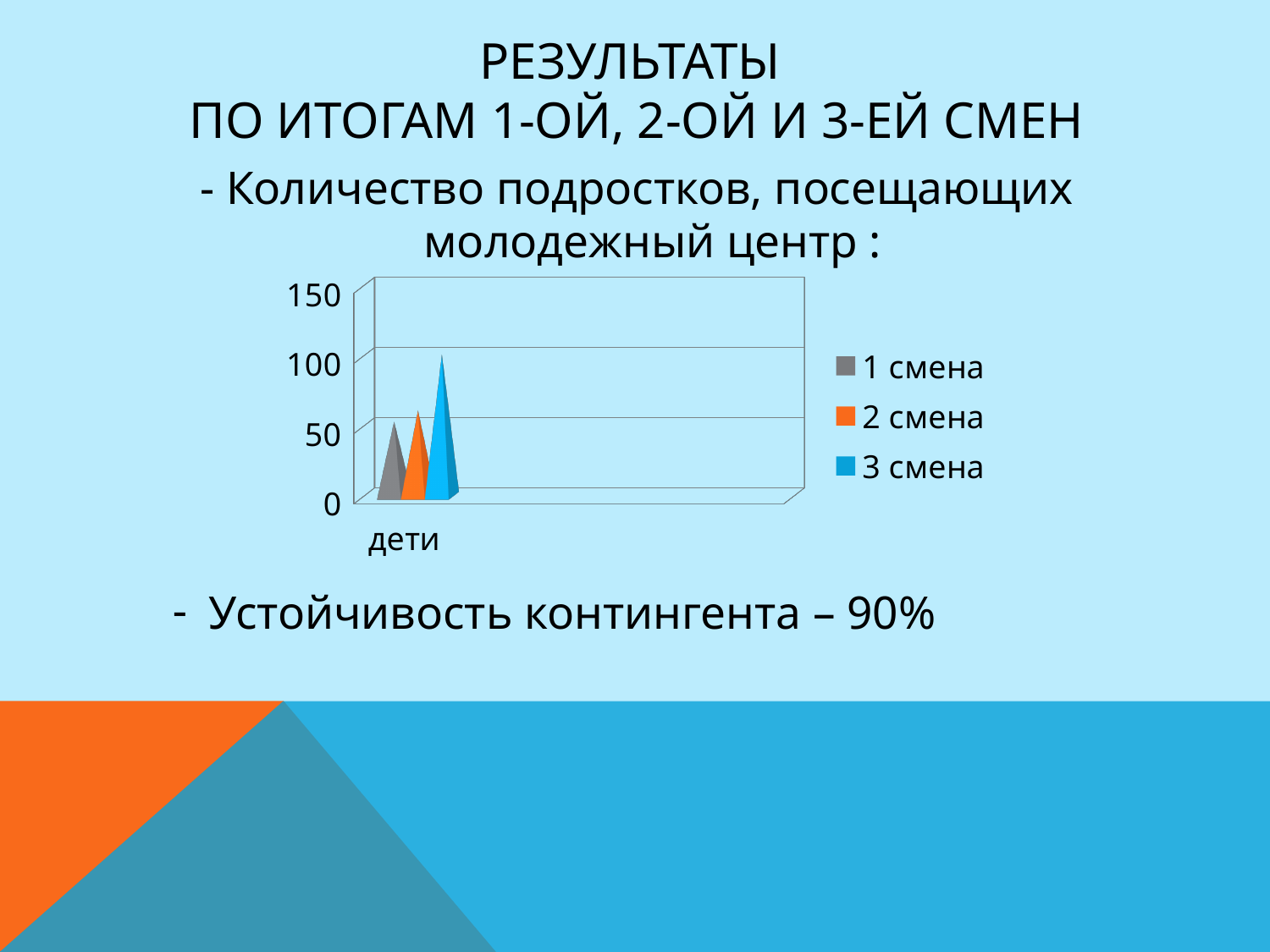
Is the value for 3 смена greater or less than 150? less Which series has the lowest value for дети? 1 смена How many categories are shown on the x axis of the chart? 1 Which colour represents 2 смена in the chart legend? orange Is the value for 1 смена greater or less than 100? less What is the label of the category on the x axis of the chart? дети Is the value for 3 смена greater or less than 50? greater Which is larger for дети: the value for 3 смена or the value for 1 смена? 3 смена What kind of chart is shown on the slide? bar chart Which series has the highest value for дети? 3 смена How many series does the chart legend list? 3